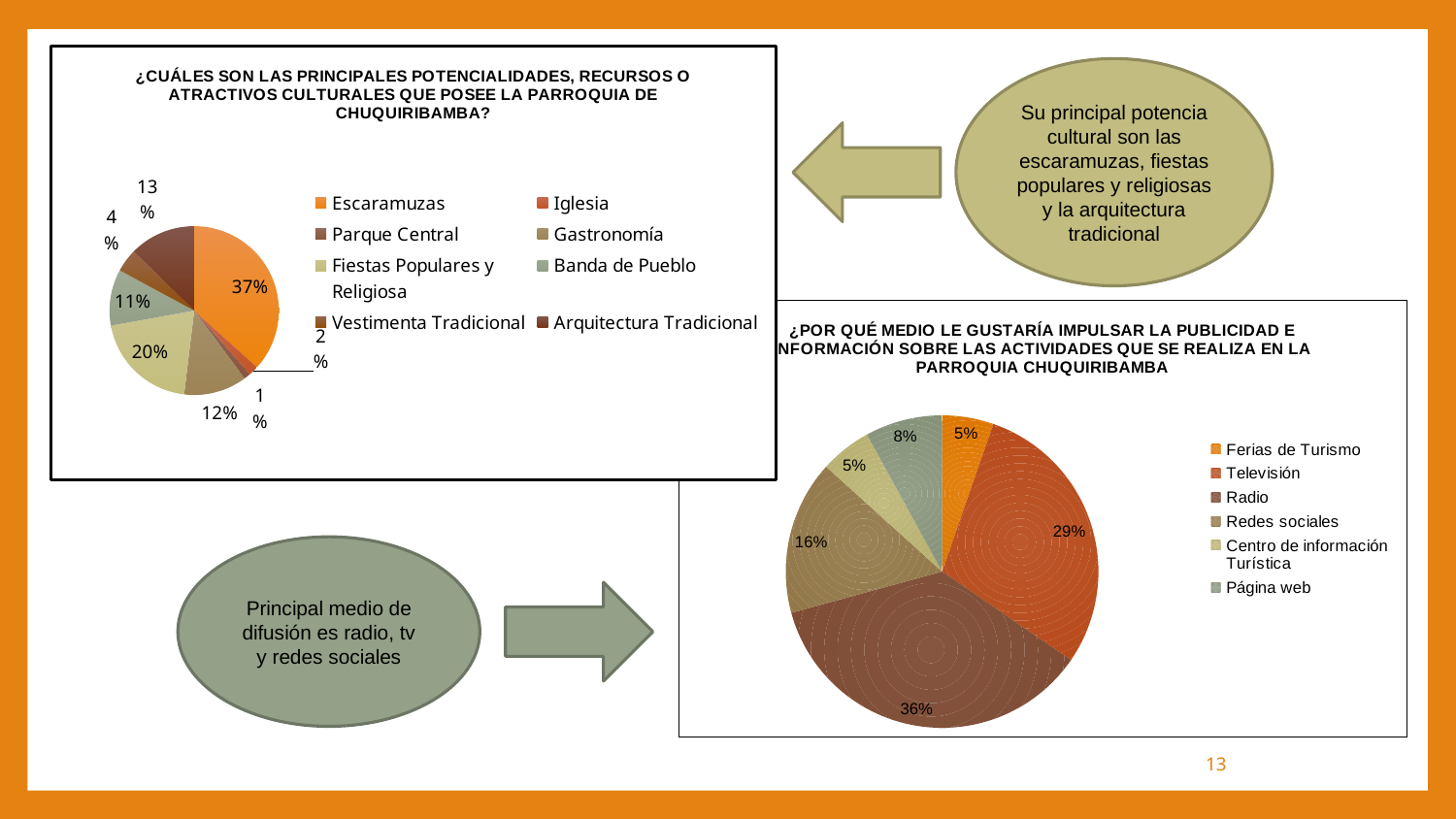
In the bottom-right pie chart, which medium has the largest share? Radio In the top-left pie chart, which category has the largest share? Escaramuzas In the bottom-right chart about the preferred medium for publicity, what percentage is shown for Redes sociales? 16% In the chart titled '¿CUÁLES SON LAS PRINCIPALES POTENCIALIDADES, RECURSOS O ATRACTIVOS CULTURALES QUE POSEE LA PARROQUIA DE CHUQUIRIBAMBA?', what percentage is shown for Escaramuzas? 37% What kind of chart is the top-left chart about cultural attractions of Chuquiribamba? Pie chart How many categories does the legend of the bottom-right pie chart list? 6 In the bottom-right chart about the preferred medium for publicity, what percentage is shown for Radio? 36% In the bottom-right pie chart, which is larger: Redes sociales or Página web? Redes sociales How many categories does the legend of the top-left pie chart list? 8 In the bottom-right pie chart, what is the difference in percentage points between Radio and Televisión? 7 percentage points In the bottom-right chart about the preferred medium for publicity, what percentage is shown for Televisión? 29% In the bottom-right chart about the preferred medium for publicity, what percentage is shown for Página web? 8%